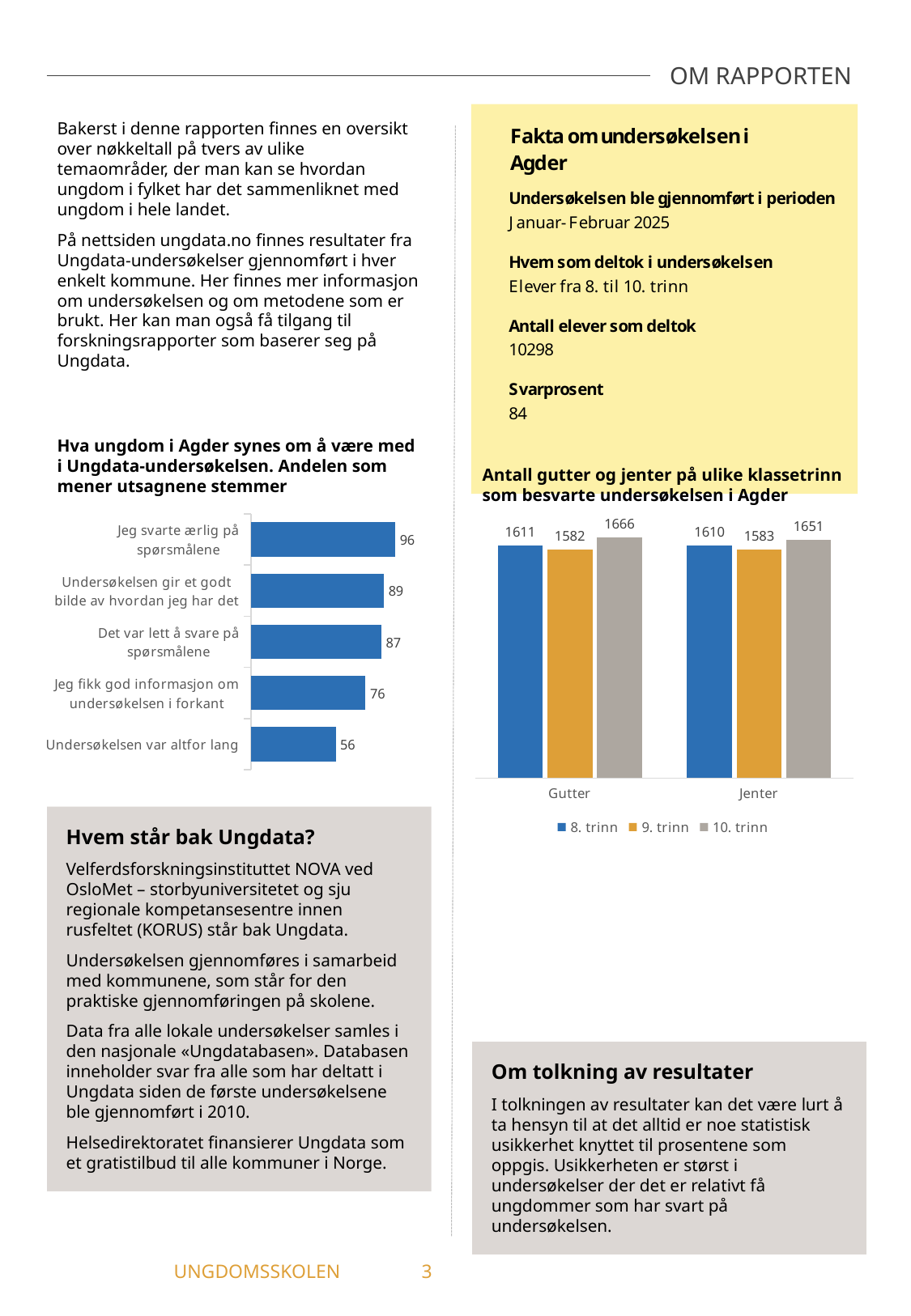
In the left chart 'Hva ungdom i Agder synes om å være med i Ungdata-undersøkelsen', what is the value for 'Jeg svarte ærlig på spørsmålene'? 96 In the left chart 'Hva ungdom i Agder synes om å være med i Ungdata-undersøkelsen', which statement has the lowest value? Undersøkelsen var altfor lang In the right chart 'Antall gutter og jenter på ulike klassetrinn', what is the value for Gutter in 10. trinn? 1666 In the left chart 'Hva ungdom i Agder synes om å være med i Ungdata-undersøkelsen', what is the value for 'Undersøkelsen var altfor lang'? 56 In the right chart 'Antall gutter og jenter på ulike klassetrinn', how many series does the legend list? 3 In the right chart 'Antall gutter og jenter på ulike klassetrinn', which is larger: Gutter in 8. trinn or Gutter in 9. trinn? Gutter in 8. trinn In the left chart 'Hva ungdom i Agder synes om å være med i Ungdata-undersøkelsen', what is the difference between 'Undersøkelsen gir et godt bilde av hvordan jeg har det' and 'Jeg fikk god informasjon om undersøkelsen i forkant'? 13 In the right chart 'Antall gutter og jenter på ulike klassetrinn', what is the value for Jenter in 9. trinn? 1583 In the right chart 'Antall gutter og jenter på ulike klassetrinn', what is the total number of Jenter across all three grades? 4844 In the right chart 'Antall gutter og jenter på ulike klassetrinn', what is the difference between Gutter and Jenter in 10. trinn? 15 How many statements (bars) are shown in the left chart 'Hva ungdom i Agder synes om å være med i Ungdata-undersøkelsen'? 5 What kind of chart is the left chart 'Hva ungdom i Agder synes om å være med i Ungdata-undersøkelsen'? Bar chart